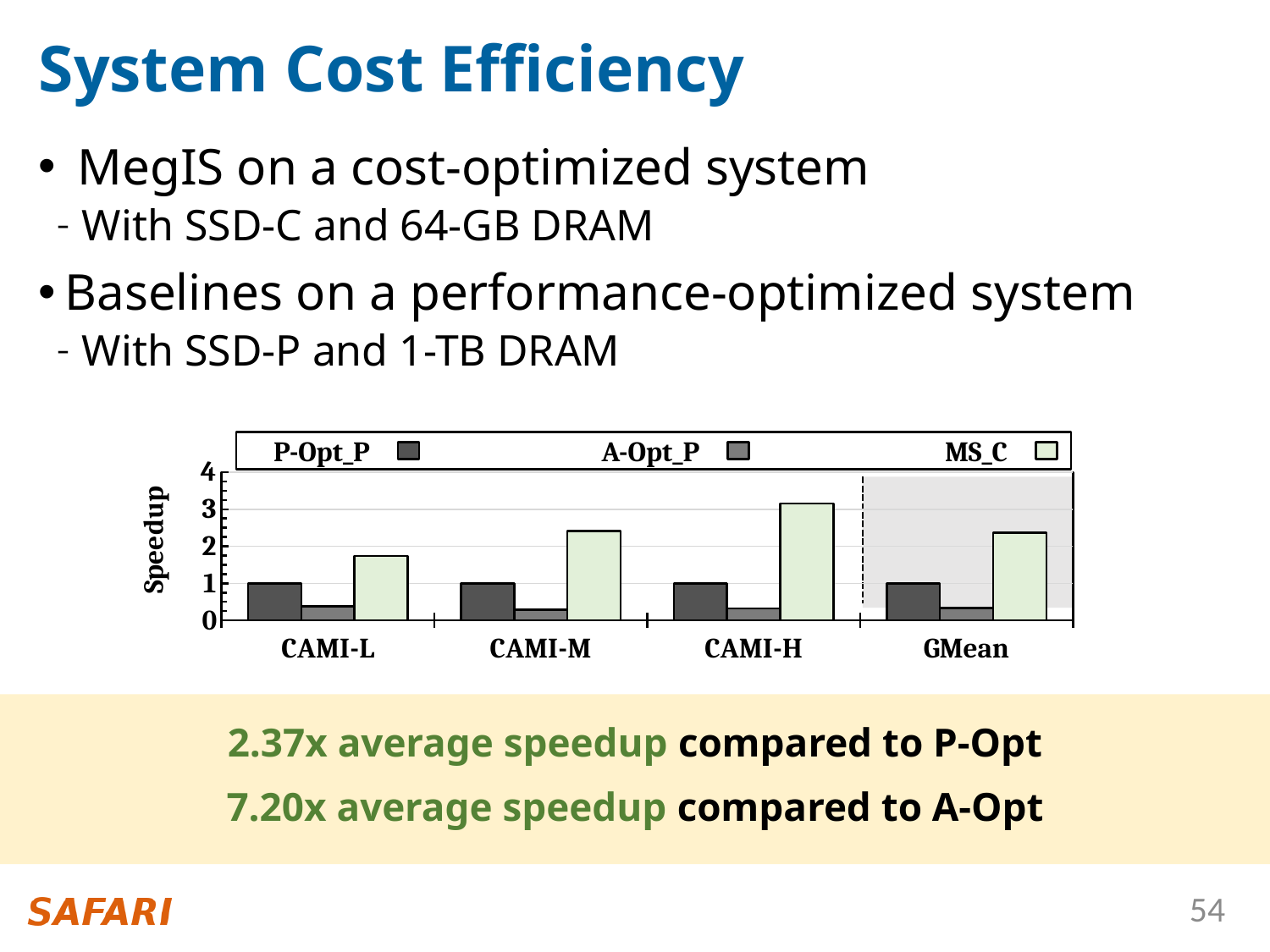
Is the MS_C value for CAMI-H greater or less than 3? greater Which category has the highest MS_C bar? CAMI-H What kind of chart is shown on the slide? bar chart Is the MS_C value for CAMI-L greater or less than 2? less Which category has the lowest MS_C bar? CAMI-L How many categories are shown along the x axis of the chart? 4 For CAMI-M, which is larger: the MS_C bar or the A-Opt_P bar? MS_C Is the A-Opt_P value for CAMI-M greater or less than 1? less What is the P-Opt_P speedup value for CAMI-L? 1 What is the label on the y axis of the chart? Speedup Do the MS_C values rise or fall going from CAMI-L to CAMI-M to CAMI-H? rise How many series does the chart's legend list? 3